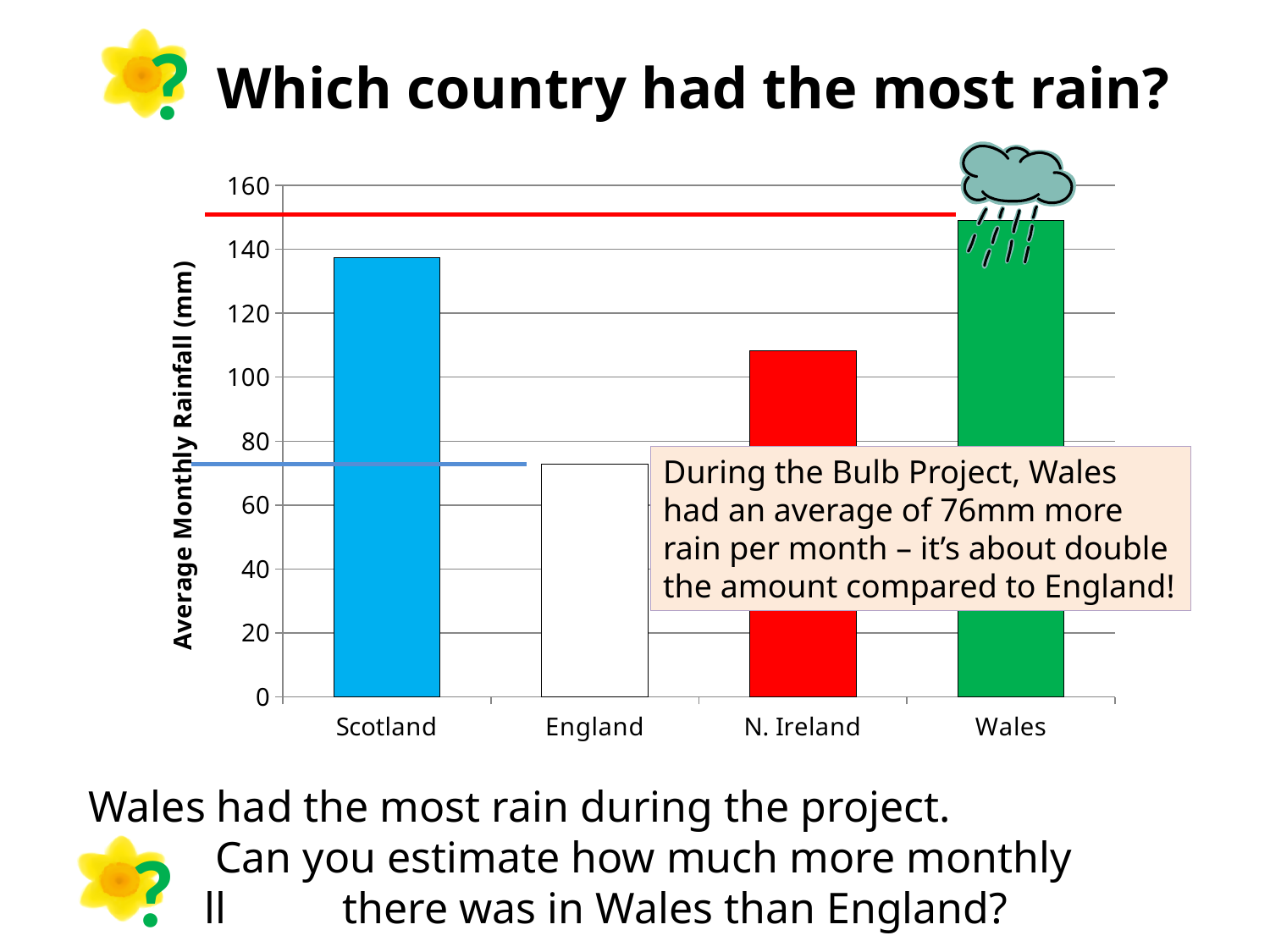
What is the label on the vertical axis of the chart? Average Monthly Rainfall (mm) Is the value for N. Ireland greater or less than 100? greater Is the value for England greater or less than 80? less Which has the higher average monthly rainfall, England or N. Ireland? N. Ireland Is the value for Scotland greater or less than 140? less Which country has the lowest average monthly rainfall in the chart? England Which has the higher average monthly rainfall, Scotland or N. Ireland? Scotland Which country has the highest average monthly rainfall in the chart? Wales What kind of chart is shown on the slide? Bar chart How many countries are shown in the chart? 4